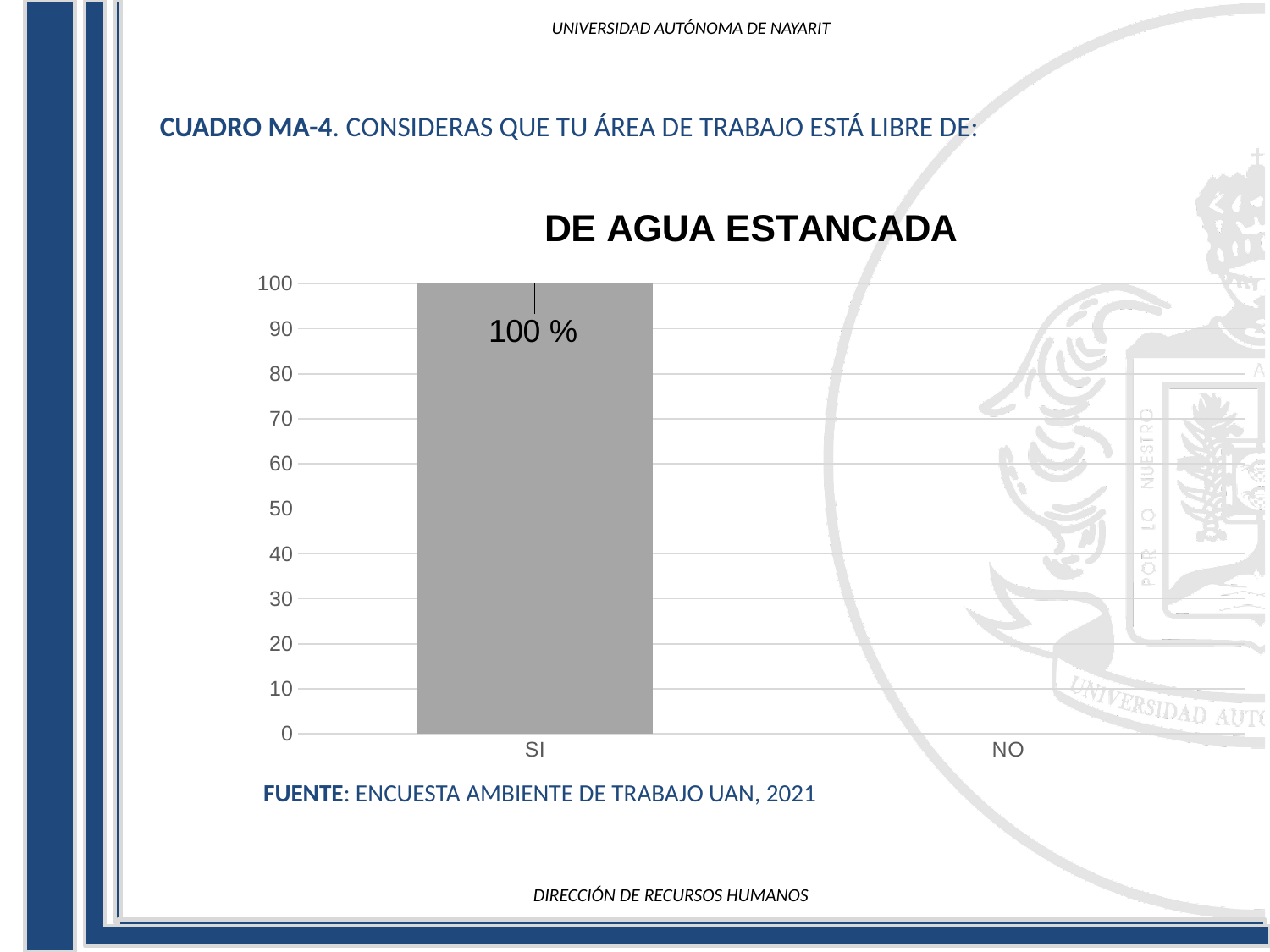
Which category has the larger value, SI or NO? SI Which category has the highest value? SI Is the value for SI greater or less than 50? greater What is the title of the chart? DE AGUA ESTANCADA Which category has the lowest value? NO Do the values rise or fall going from SI to NO along the x axis? fall What is the value shown for the SI category? 100 % How many categories are shown on the x axis of the chart? 2 What is the highest tick value shown on the vertical axis of the chart? 100 What kind of chart is shown on the slide? bar chart